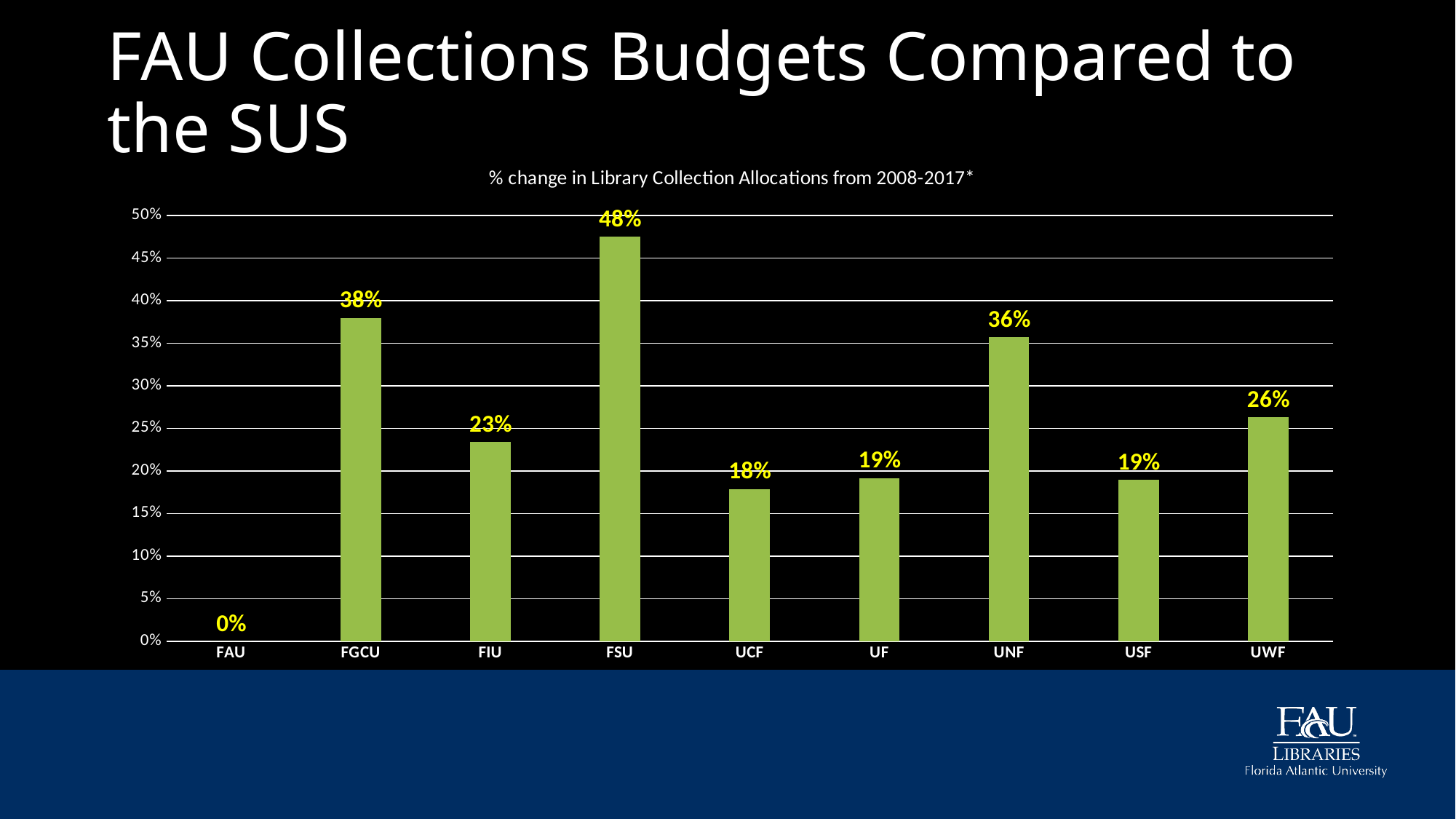
Which has a larger % change in library collection allocations, UWF or UCF? UWF What kind of chart is shown on the slide? bar chart What is the % change in library collection allocations for FSU? 48% Is the value for UNF greater or less than 30%? greater Which university has the lowest % change in library collection allocations? FAU What is the difference between the % change for FGCU and the % change for FIU? 15% What colour are the bars in the chart? green How many universities are shown on the x axis of the chart? 9 Which university has the highest % change in library collection allocations? FSU What is the % change in library collection allocations for FAU? 0% What is the % change in library collection allocations for UNF? 36% What is the title of the chart? % change in Library Collection Allocations from 2008-2017*